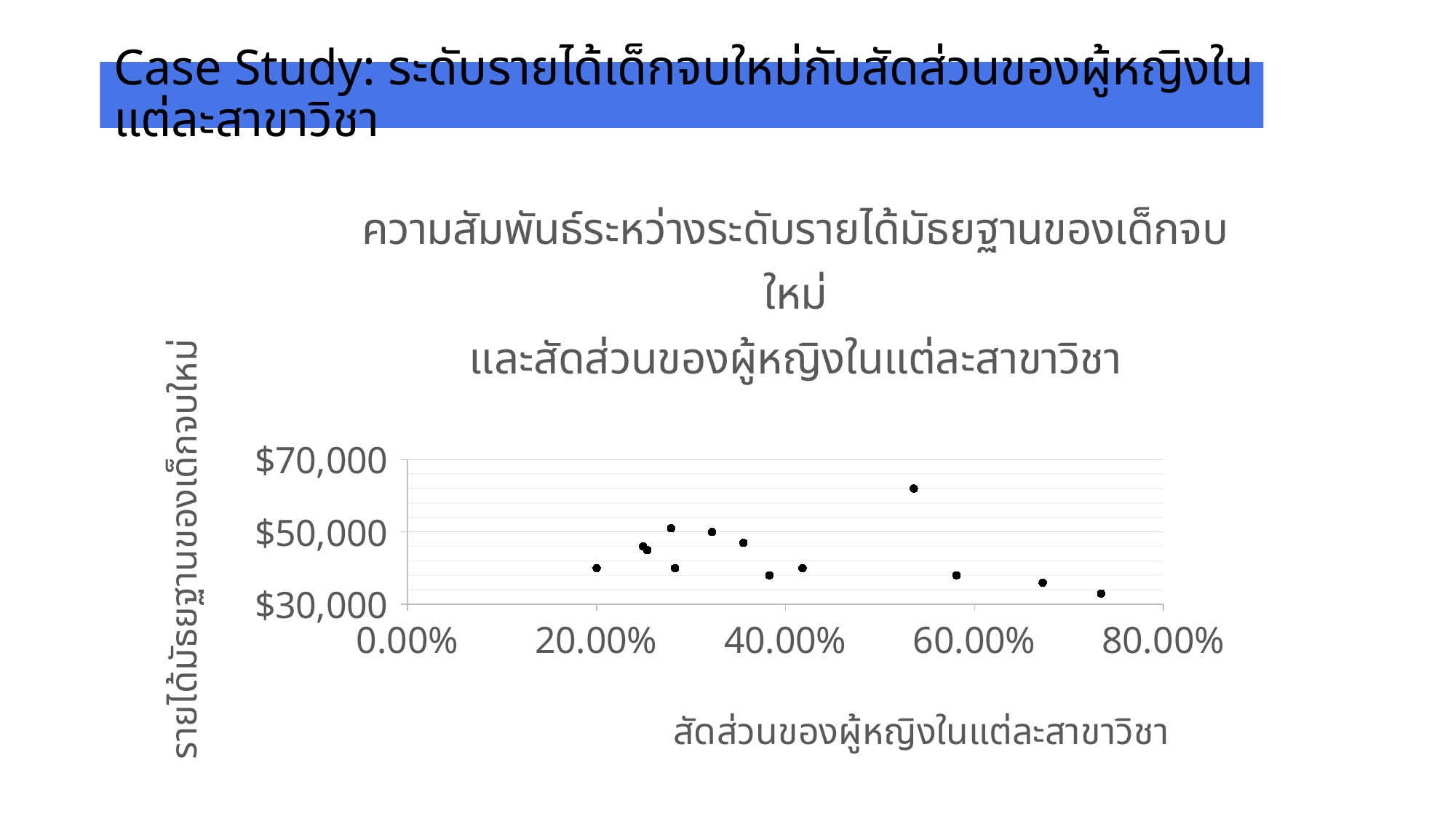
What is the label of the y axis? รายได้มัธยฐานของเด็กจบใหม่ What kind of chart is shown on the slide? scatter plot Is the lowest plotted income value greater or less than $40,000? less What is the highest value shown on the y axis? $70,000 Is the point with the lowest income located at a share of women greater or less than 60.00%? greater Are all plotted points at a share of women less than 80.00%? yes What is the label of the x axis? สัดส่วนของผู้หญิงในแต่ละสาขาวิชา Overall, do the income values tend to rise or fall as the share of women increases along the x axis? fall